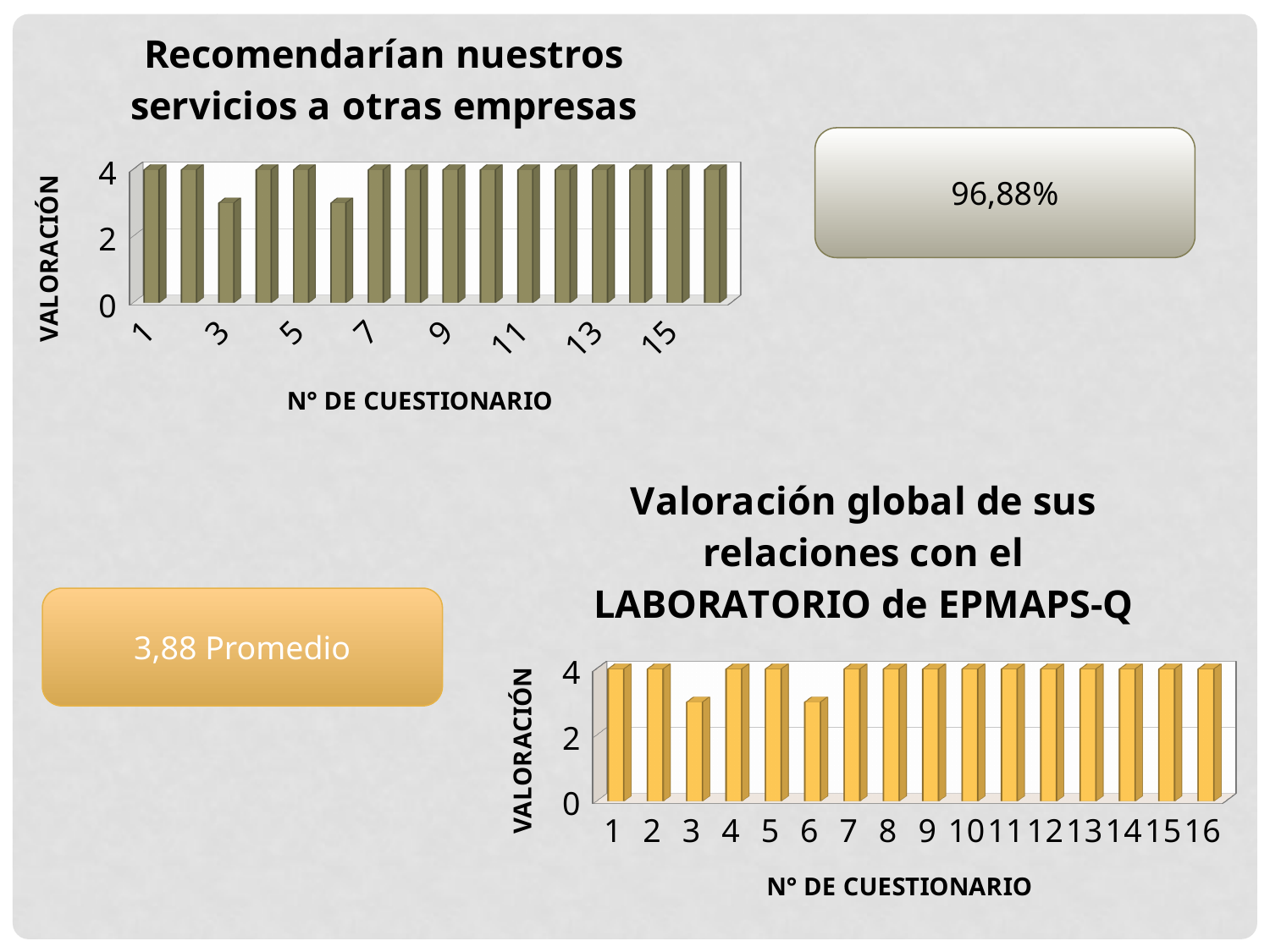
In the top chart 'Recomendarían nuestros servicios a otras empresas', which has the larger value, questionnaire 3 or questionnaire 5? questionnaire 5 In the top chart 'Recomendarían nuestros servicios a otras empresas', what is the valoración for questionnaire 7? 4 How many bars are plotted in the top chart 'Recomendarían nuestros servicios a otras empresas'? 16 What is the x-axis title of the top chart 'Recomendarían nuestros servicios a otras empresas'? N° DE CUESTIONARIO In the bottom chart 'Valoración global de sus relaciones con el LABORATORIO de EPMAPS-Q', how many questionnaires (bars) are plotted? 16 What kind of chart is the top chart titled 'Recomendarían nuestros servicios a otras empresas'? bar chart In the bottom chart 'Valoración global de sus relaciones con el LABORATORIO de EPMAPS-Q', what is the valoración for questionnaire 16? 4 In the bottom chart 'Valoración global de sus relaciones con el LABORATORIO de EPMAPS-Q', is the value for questionnaire 3 greater or less than 2? greater What is the y-axis title of the bottom chart 'Valoración global de sus relaciones con el LABORATORIO de EPMAPS-Q'? VALORACIÓN In the bottom chart 'Valoración global de sus relaciones con el LABORATORIO de EPMAPS-Q', what is the valoración for questionnaire 1? 4 In the top chart 'Recomendarían nuestros servicios a otras empresas', is the value for questionnaire 3 greater or less than 2? greater In the bottom chart 'Valoración global de sus relaciones con el LABORATORIO de EPMAPS-Q', which has the larger value, questionnaire 3 or questionnaire 4? questionnaire 4